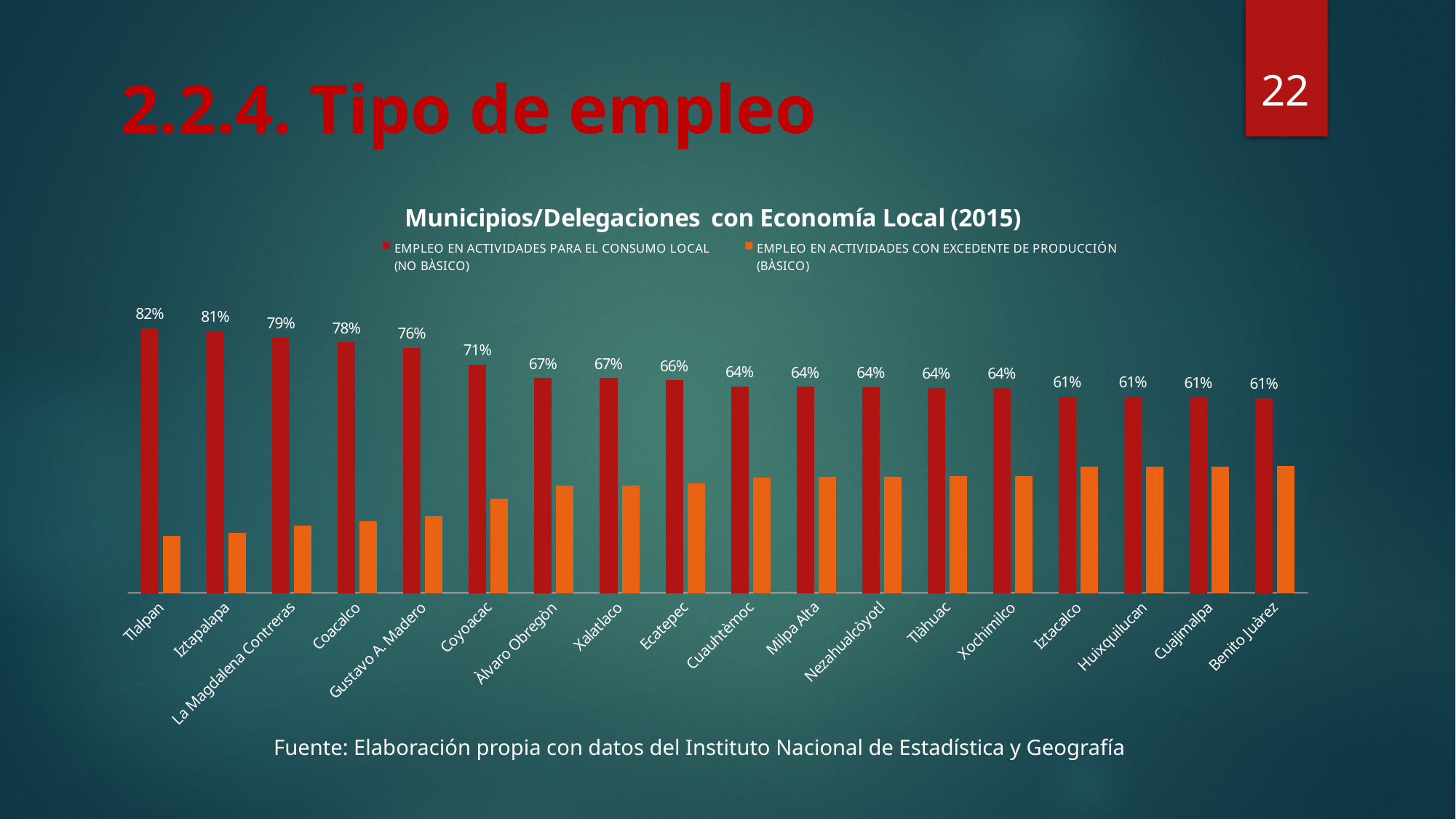
How many municipalities/delegations are shown on the x axis? 18 What is the difference between the EMPLEO EN ACTIVIDADES PARA EL CONSUMO LOCAL (NO BÀSICO) values for Tlalpan and Coacalco? 4% What is the title of the chart? Municipios/Delegaciones con Economía Local (2015) Do the values for EMPLEO EN ACTIVIDADES PARA EL CONSUMO LOCAL (NO BÀSICO) rise or fall from left to right along the x axis? fall How many series does the legend list? 2 Which has a higher value for EMPLEO EN ACTIVIDADES PARA EL CONSUMO LOCAL (NO BÀSICO), Iztapalapa or Coyoacac? Iztapalapa For Benito Juàrez, which series has the larger bar, EMPLEO EN ACTIVIDADES PARA EL CONSUMO LOCAL (NO BÀSICO) or EMPLEO EN ACTIVIDADES CON EXCEDENTE DE PRODUCCIÓN (BÀSICO)? EMPLEO EN ACTIVIDADES PARA EL CONSUMO LOCAL (NO BÀSICO) What type of chart is shown on the slide? bar chart What is the value of EMPLEO EN ACTIVIDADES PARA EL CONSUMO LOCAL (NO BÀSICO) for Ecatepec? 66% What is the value of EMPLEO EN ACTIVIDADES PARA EL CONSUMO LOCAL (NO BÀSICO) for Gustavo A. Madero? 76% What is the value of EMPLEO EN ACTIVIDADES PARA EL CONSUMO LOCAL (NO BÀSICO) for Tlalpan? 82% Which municipality/delegation has the highest value for EMPLEO EN ACTIVIDADES PARA EL CONSUMO LOCAL (NO BÀSICO)? Tlalpan